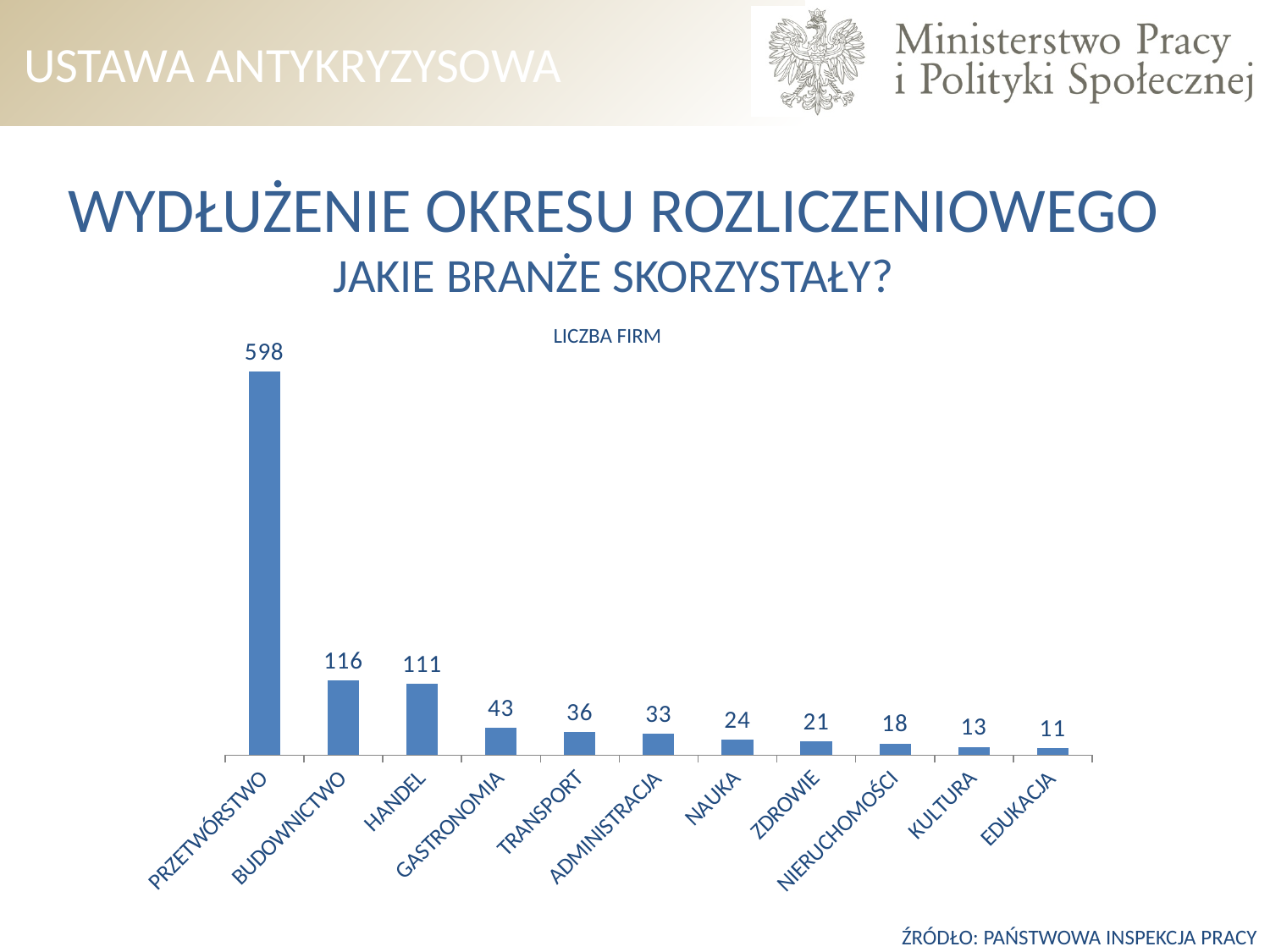
What is the value for PRZETWÓRSTWO? 598 Which category has the highest value? PRZETWÓRSTWO What is the value for NIERUCHOMOŚCI? 18 How many categories are shown on the x axis? 11 Do the values rise or fall from left to right along the x axis? fall What is the difference between the values for BUDOWNICTWO and HANDEL? 5 What is the difference between the values for GASTRONOMIA and TRANSPORT? 7 What is the title of the chart? LICZBA FIRM What is the value for HANDEL? 111 Which category has the lowest value? EDUKACJA Which is larger, the value for NAUKA or the value for ZDROWIE? NAUKA What kind of chart is shown on the slide? bar chart